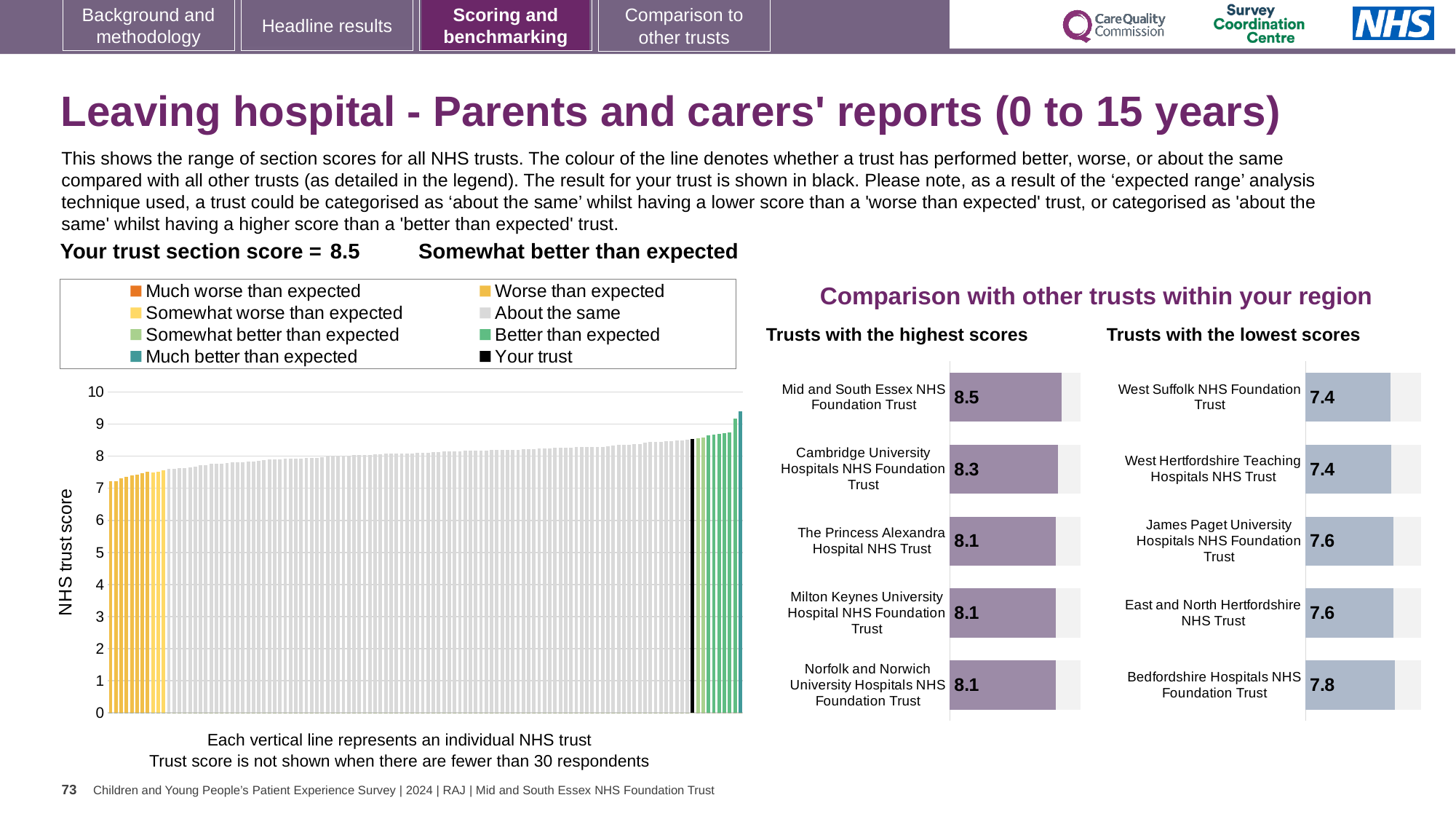
In the 'Trusts with the lowest scores' chart, what is the score for Bedfordshire Hospitals NHS Foundation Trust? 7.8 In the large chart on the left, do the trust scores rise or fall from left to right? Rise In the 'Trusts with the highest scores' chart, which trust has the highest score? Mid and South Essex NHS Foundation Trust In the 'Trusts with the lowest scores' chart, which has the larger score: East and North Hertfordshire NHS Trust or West Hertfordshire Teaching Hospitals NHS Trust? East and North Hertfordshire NHS Trust How many trusts are shown in the 'Trusts with the highest scores' chart? 5 In the 'Trusts with the lowest scores' chart, what is the score for James Paget University Hospitals NHS Foundation Trust? 7.6 How many entries does the legend above the large chart on the left list? 8 What kind of chart is the large chart on the left with the y-axis labelled 'NHS trust score'? Bar chart In the 'Trusts with the highest scores' chart, what is the score for Cambridge University Hospitals NHS Foundation Trust? 8.3 In the 'Trusts with the lowest scores' chart, what is the difference between the scores of Bedfordshire Hospitals NHS Foundation Trust and West Suffolk NHS Foundation Trust? 0.4 In the 'Trusts with the lowest scores' chart, which trust has the highest score? Bedfordshire Hospitals NHS Foundation Trust In the 'Trusts with the highest scores' chart, what is the difference between the scores of Mid and South Essex NHS Foundation Trust and Cambridge University Hospitals NHS Foundation Trust? 0.2